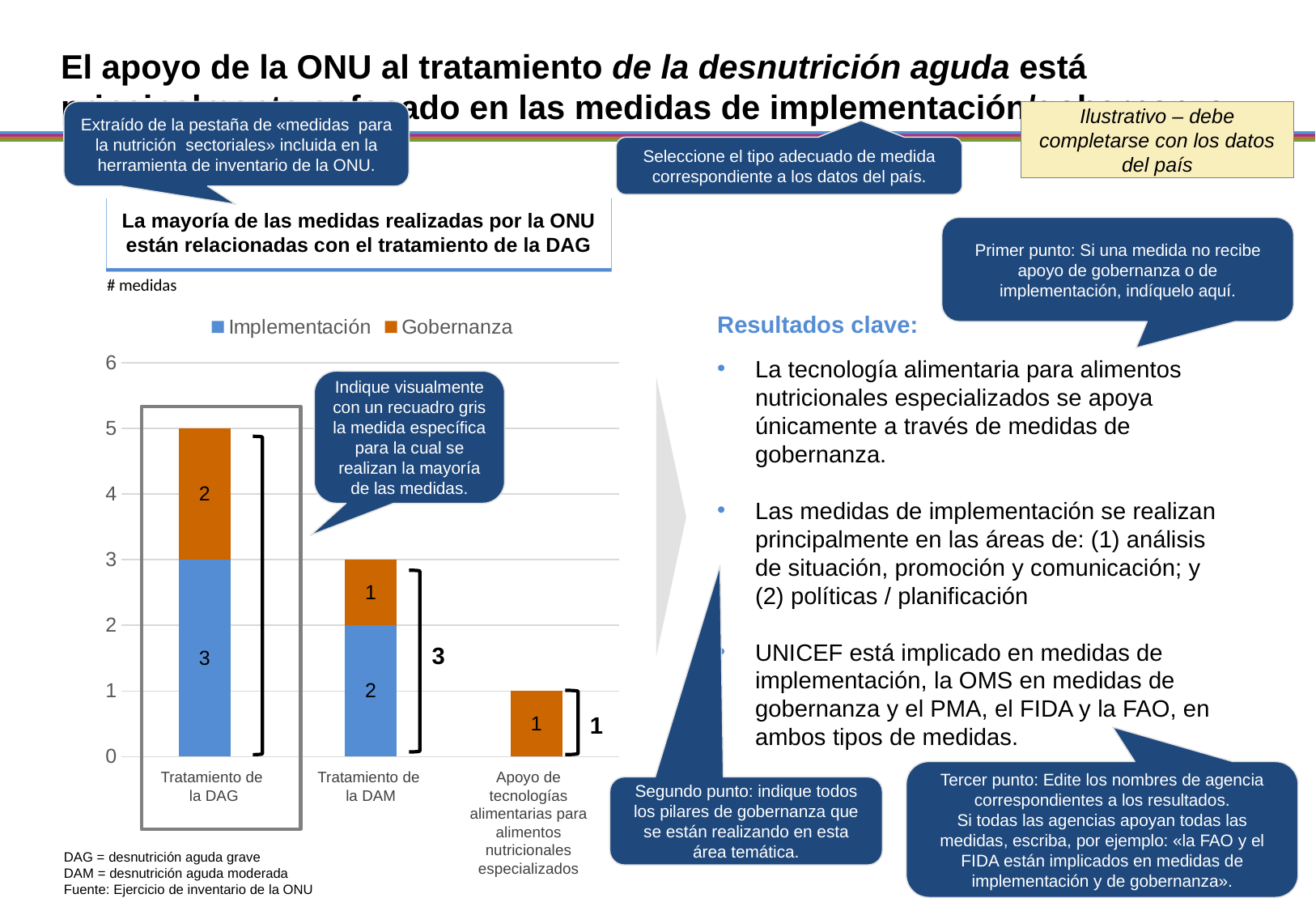
How many series does the chart legend list? 2 Which category has the highest total number of measures? Tratamiento de la DAG What is the Gobernanza value for Tratamiento de la DAG? 2 What is the total number of measures for the Tratamiento de la DAG bar? 5 What is the difference between the Implementación values for Tratamiento de la DAG and Tratamiento de la DAM? 1 What is the Implementación value for Tratamiento de la DAM? 2 How many categories are shown on the x axis of the chart? 3 What is the Gobernanza value for Apoyo de tecnologías alimentarias para alimentos nutricionales especializados? 1 What is the Implementación value for Tratamiento de la DAG? 3 What type of chart is shown on the slide? Stacked bar chart Which series is shown in orange in the chart legend? Gobernanza What is the total number of measures for the Tratamiento de la DAM bar? 3